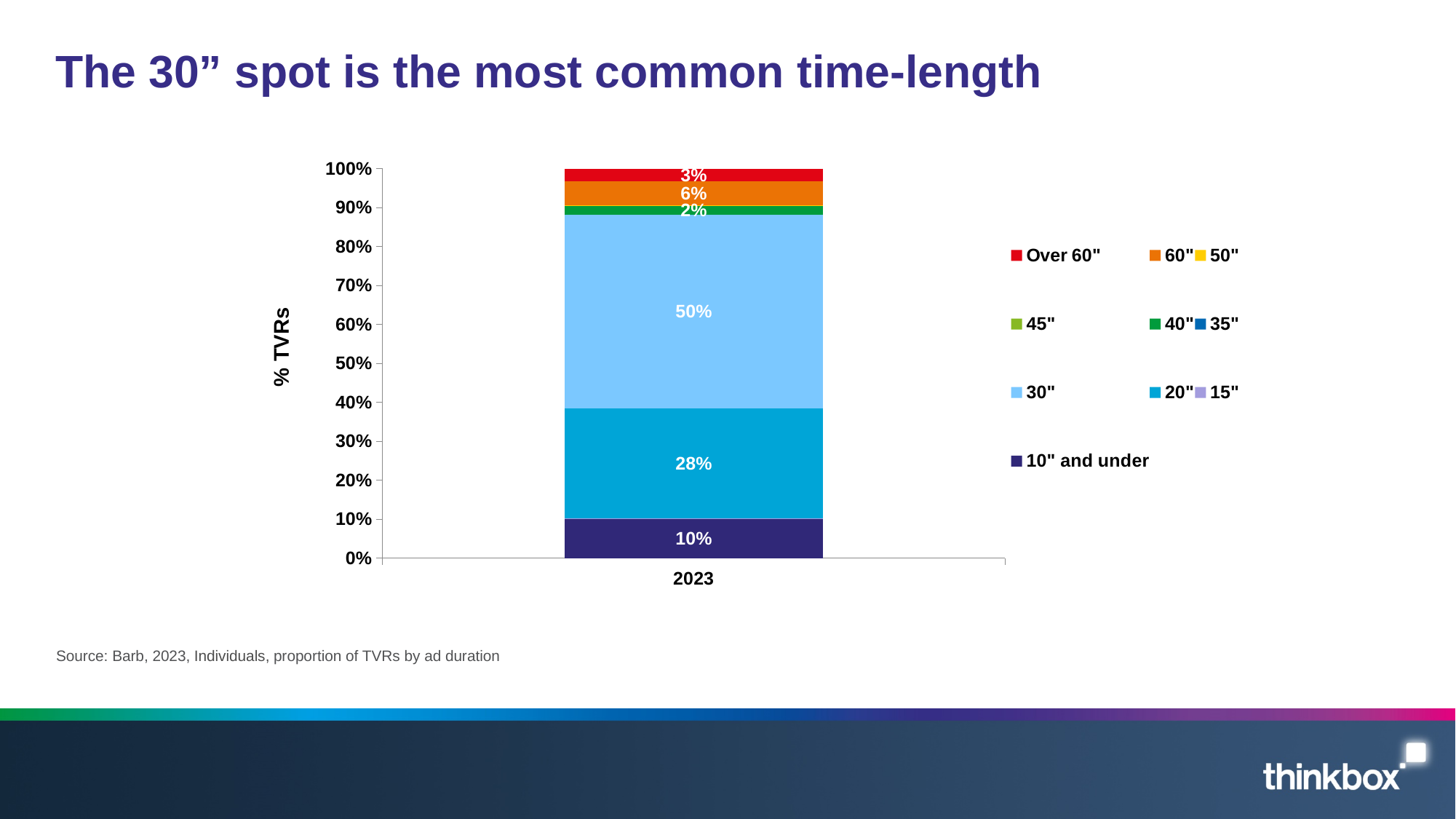
What is the label on the vertical axis? % TVRs What is the value shown for the 10" and under segment? 10% Which is larger, the 20" share or the 10" and under share? 20" What share of TVRs does the 30" segment account for in 2023? 50% What is the value shown for the 20" segment in 2023? 28% What type of chart is shown on the slide? Stacked bar chart How many percentage points larger is the 30" share than the 20" share? 22 percentage points How many series does the legend list? 10 Which ad duration has the largest share of TVRs in 2023? 30" What is the value shown for the 60" segment? 6% How many years (categories) are shown on the x axis? 1 What is the value shown for the Over 60" segment at the top of the bar? 3%